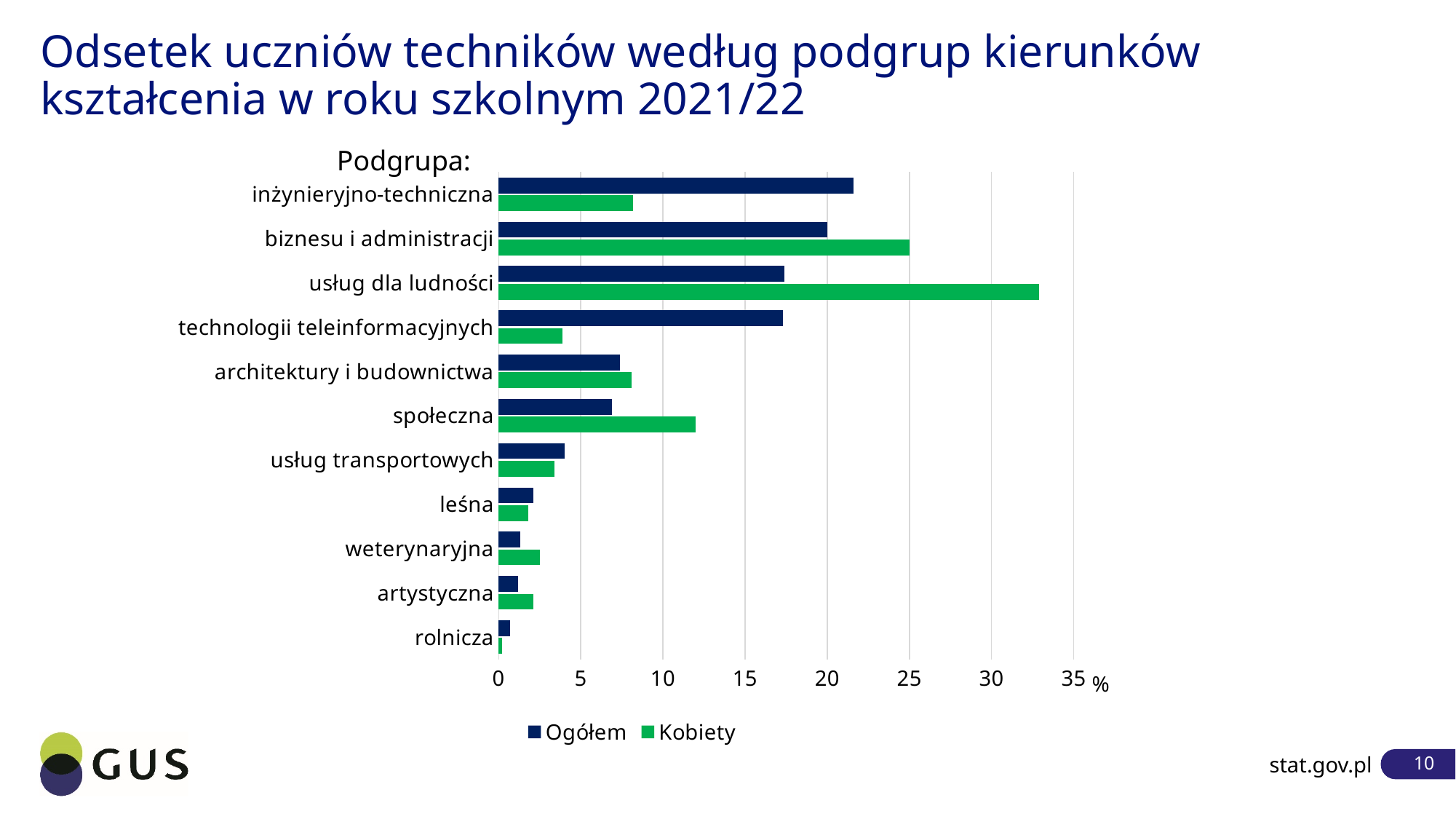
What are the two series named in the legend? Ogółem and Kobiety Which subgroup has the lowest value for Ogółem? rolnicza Is the Kobiety value for usług dla ludności greater or less than 30? greater Is the Ogółem value for inżynieryjno-techniczna greater or less than 20? greater For biznesu i administracji, which is larger: the Ogółem value or the Kobiety value? Kobiety Which subgroup has the highest value for Ogółem? inżynieryjno-techniczna Which subgroup has the lowest value for Kobiety? rolnicza How many series does the legend list? 2 How many subgroups (podgrupy) are shown on the chart? 11 Which subgroup has the highest value for Kobiety? usług dla ludności What kind of chart is shown on the slide? bar chart For technologii teleinformacyjnych, which is larger: the Ogółem value or the Kobiety value? Ogółem